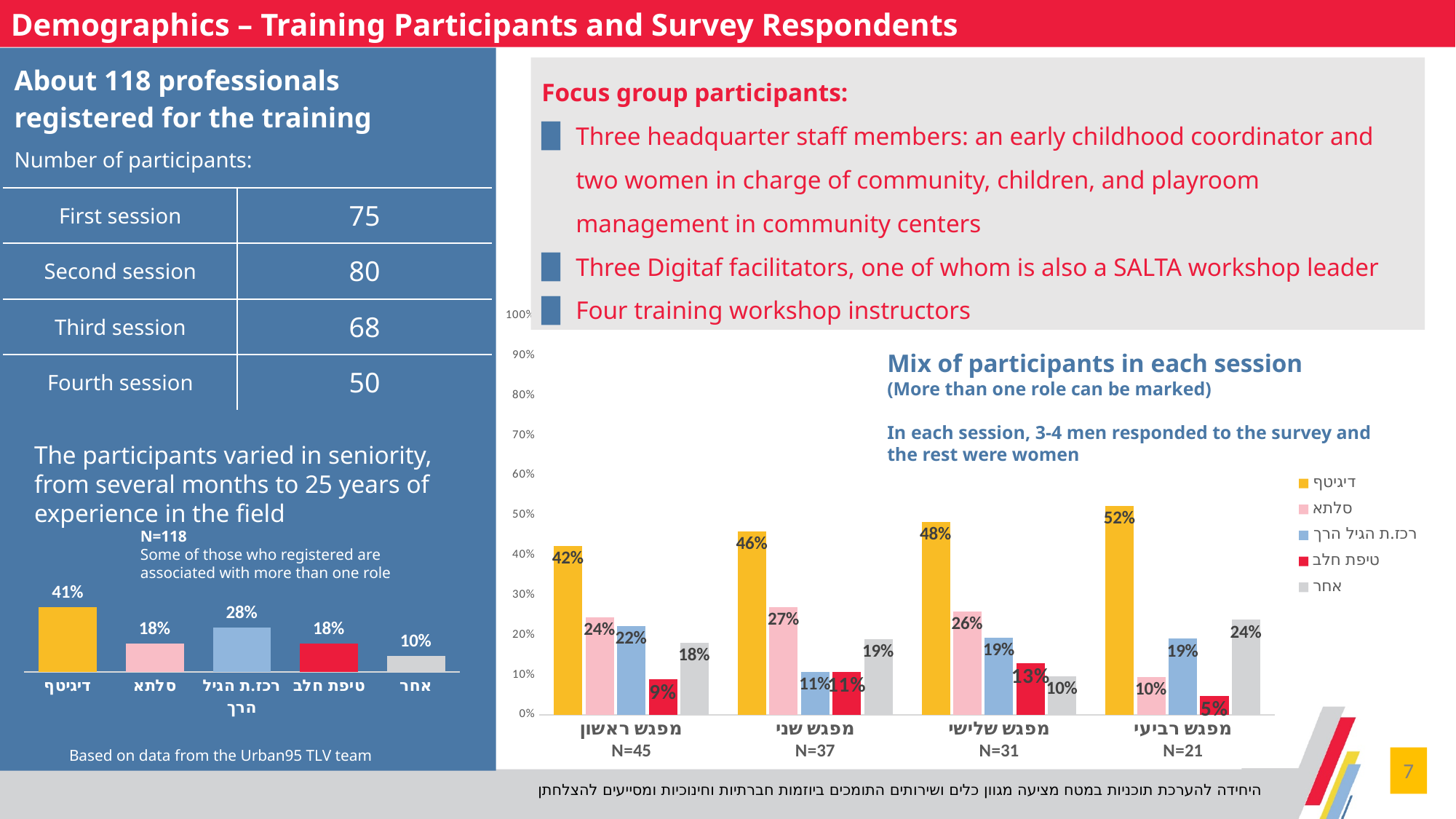
In the N=118 chart on the left of the slide, which category has the highest value? דיגיטף In the 'Mix of participants in each session' chart, what is the difference between the דיגיטף values for מפגש רביעי and מפגש ראשון? 10% In the 'Mix of participants in each session' chart, what is the value for אחר in מפגש רביעי? 24% In the N=118 chart on the left of the slide, what is the value for רכז.ת הגיל הרך? 28% In the 'Mix of participants in each session' chart, what is the value for דיגיטף in מפגש רביעי? 52% In the 'Mix of participants in each session' chart, what is the value for טיפת חלב in מפגש ראשון? 9% In the 'Mix of participants in each session' chart, which session has the highest value for דיגיטף? מפגש רביעי In the 'Mix of participants in each session' chart, which session has the lowest value for טיפת חלב? מפגש רביעי How many series does the legend of the 'Mix of participants in each session' chart list? 5 In the 'Mix of participants in each session' chart, which is larger: סלתא in מפגש שני or סלתא in מפגש רביעי? מפגש שני How many sessions are shown on the x axis of the 'Mix of participants in each session' chart? 4 In the 'Mix of participants in each session' chart, do the דיגיטף values rise or fall from מפגש ראשון to מפגש רביעי? rise